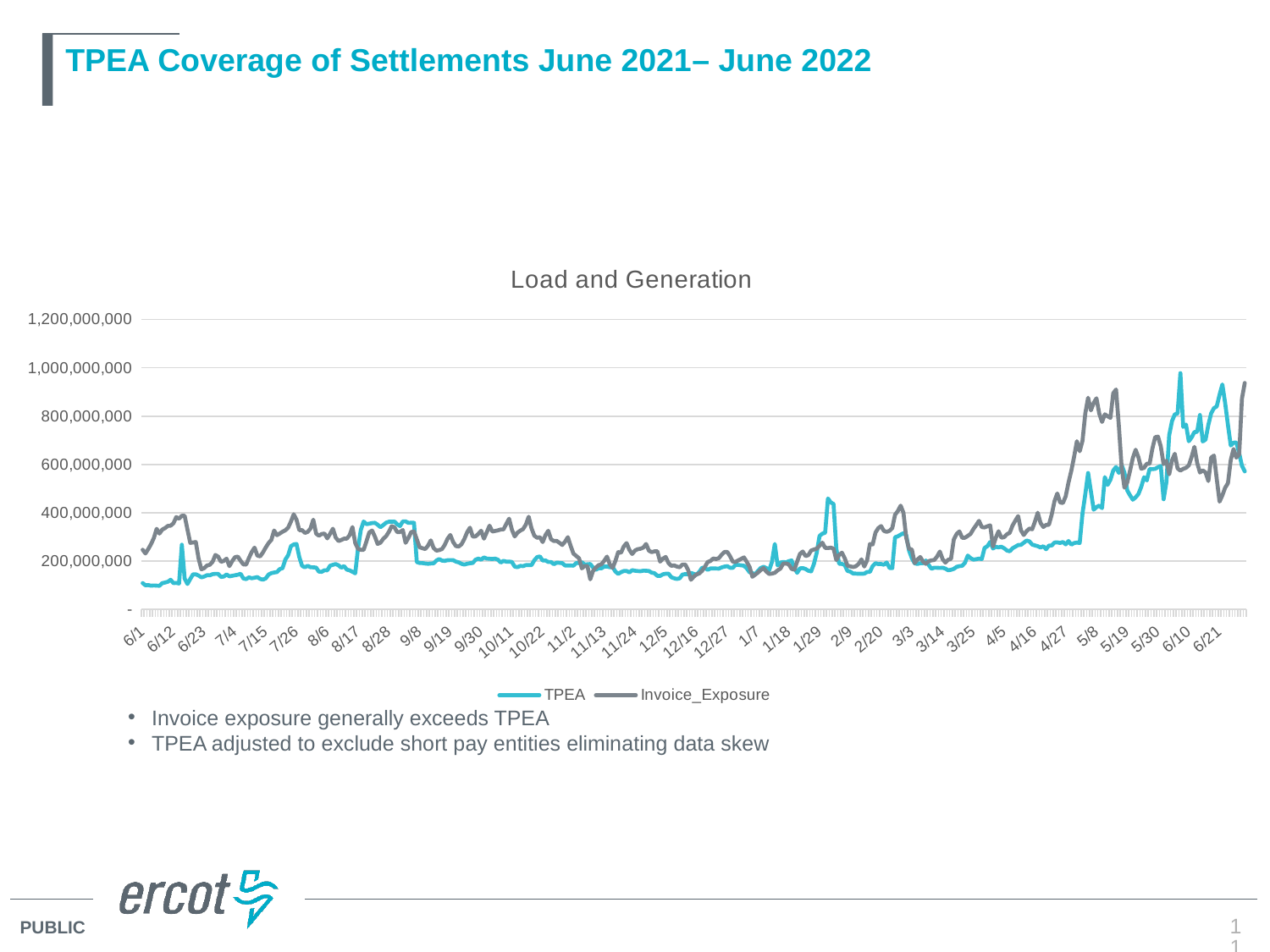
Is the highest TPEA value in the chart greater or less than 1,000,000,000? less What kind of chart is shown on the slide? Line chart Overall, do the values in the chart rise or fall from 6/1 to 6/21? rise How many series does the legend of the chart list? 2 Which series reaches the highest peak in the chart, TPEA or Invoice_Exposure? TPEA Is the TPEA value at 6/1 greater or less than 200,000,000? less What is the title of the chart? Load and Generation What is the highest value shown on the vertical axis of the chart? 1,200,000,000 Which series in the chart is drawn in gray? Invoice_Exposure At 6/1, which series has the higher value, TPEA or Invoice_Exposure? Invoice_Exposure Is the highest Invoice_Exposure value in the chart greater or less than 800,000,000? greater